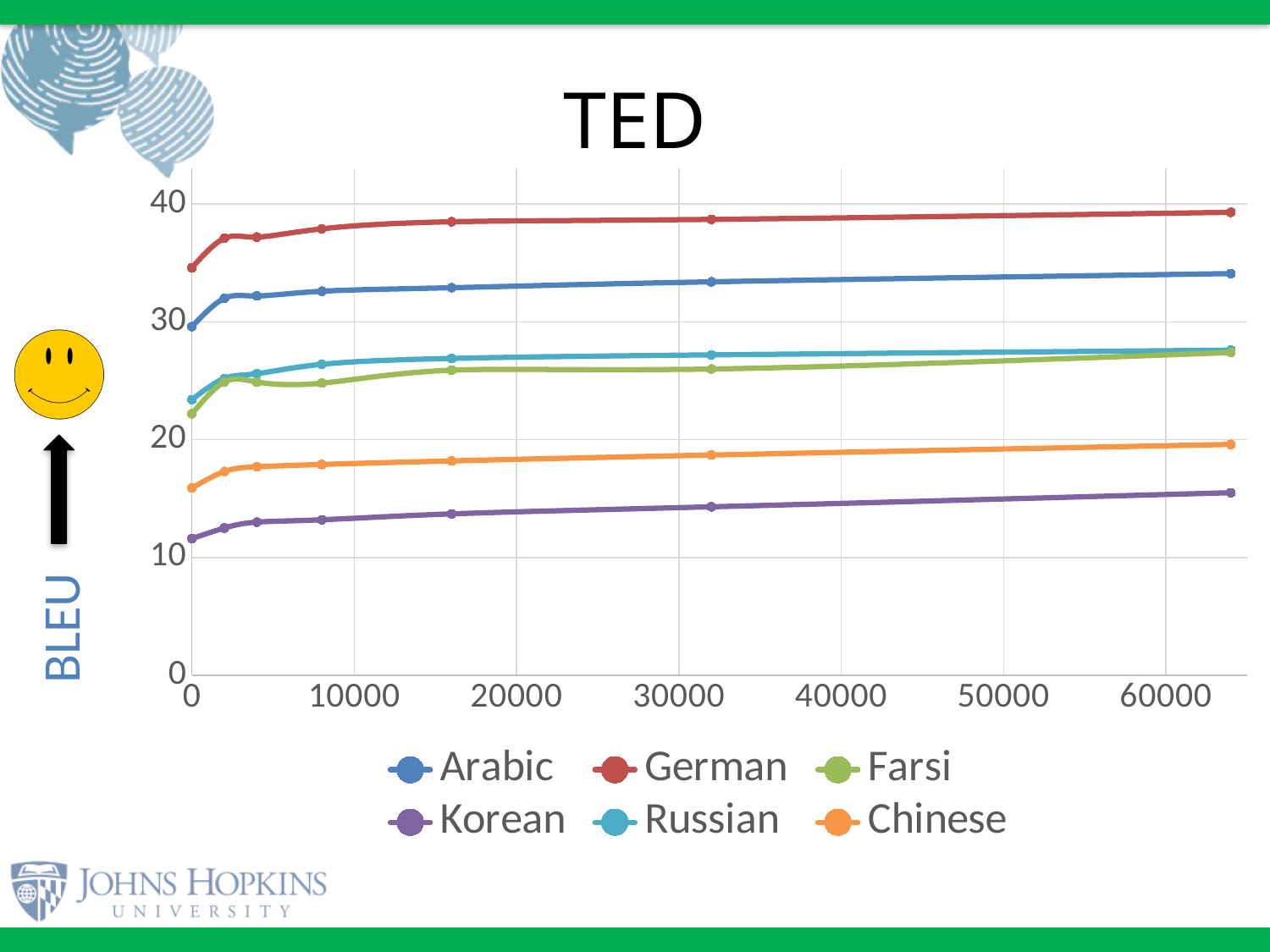
Is the BLEU value for Russian at 60000 greater or less than 30? less Which language series has the lowest BLEU scores across the chart? Korean Which series has higher BLEU scores, Chinese or Korean? Chinese Which language series has the highest BLEU scores across the chart? German What is the label on the y axis? BLEU Is the BLEU value for Korean at 0 greater or less than 10? greater What kind of chart is shown on the slide? line chart How many series does the legend list? 6 Is the BLEU value for German at 60000 greater or less than 40? less What is the title of the chart? TED Do the BLEU scores for Arabic rise or fall as the x-axis value increases? rise